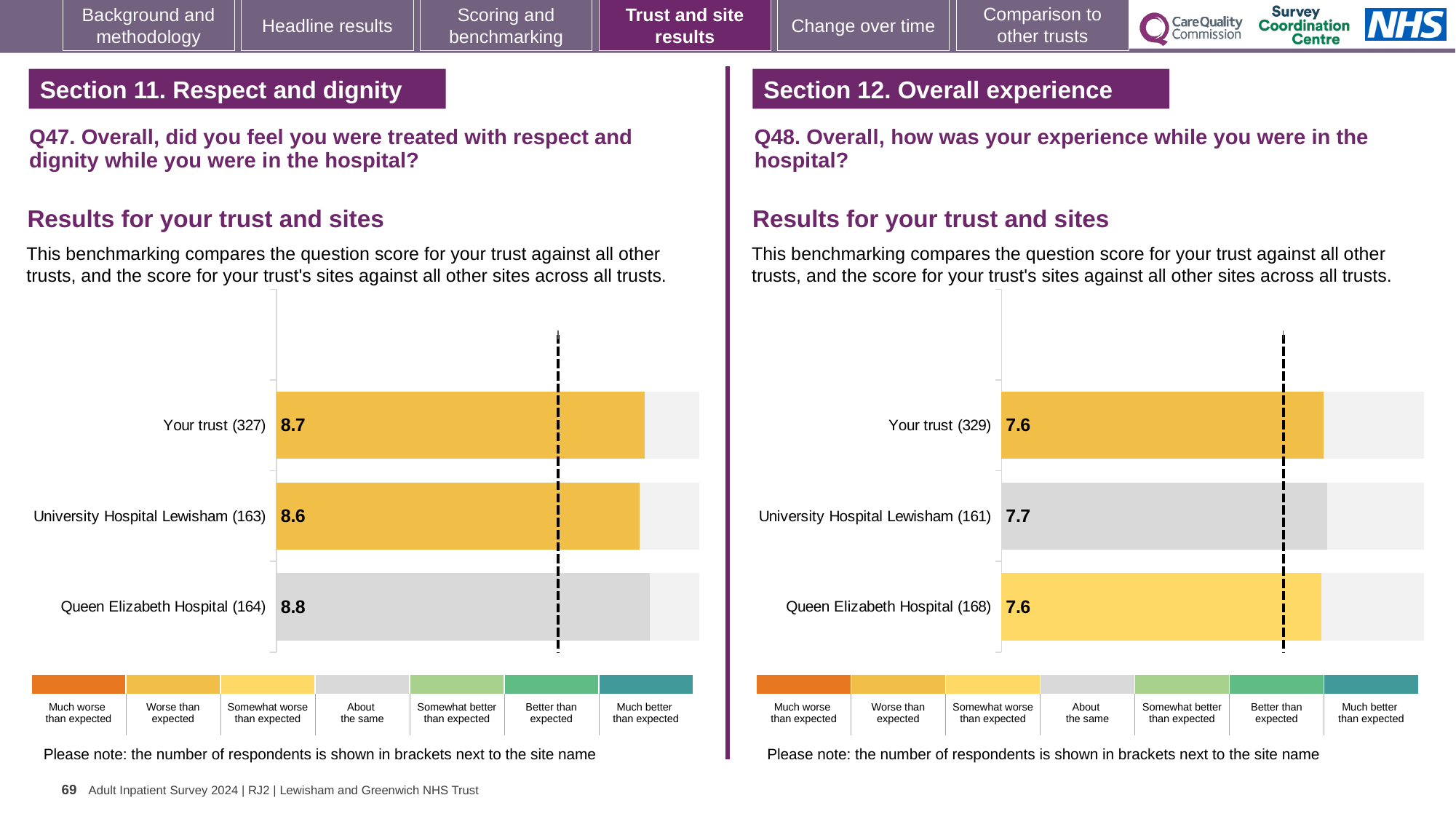
In the Q47 chart on the left, what is the score for Queen Elizabeth Hospital? 8.8 In the Q47 chart on the left, which site or trust has the lowest score? University Hospital Lewisham What type of chart is used for the Q48 results on the right? bar chart In the Q47 chart on the left, which site or trust has the highest score? Queen Elizabeth Hospital In the Q47 chart on the left, what is the difference between the scores for Queen Elizabeth Hospital and University Hospital Lewisham? 0.2 In the Q48 chart on the right, which site or trust has the highest score? University Hospital Lewisham In the Q48 chart on the right, which benchmark category does the colour of the University Hospital Lewisham bar represent? About the same In the Q48 chart on the right, is the score for University Hospital Lewisham larger or smaller than the score for Queen Elizabeth Hospital? larger In the Q48 chart on the right, what is the score for Your trust? 7.6 How many bars are shown in the Q47 chart on the left? 3 In the Q48 chart on the right, what is the score for University Hospital Lewisham? 7.7 In the Q47 chart on the left, what is the score for Your trust? 8.7